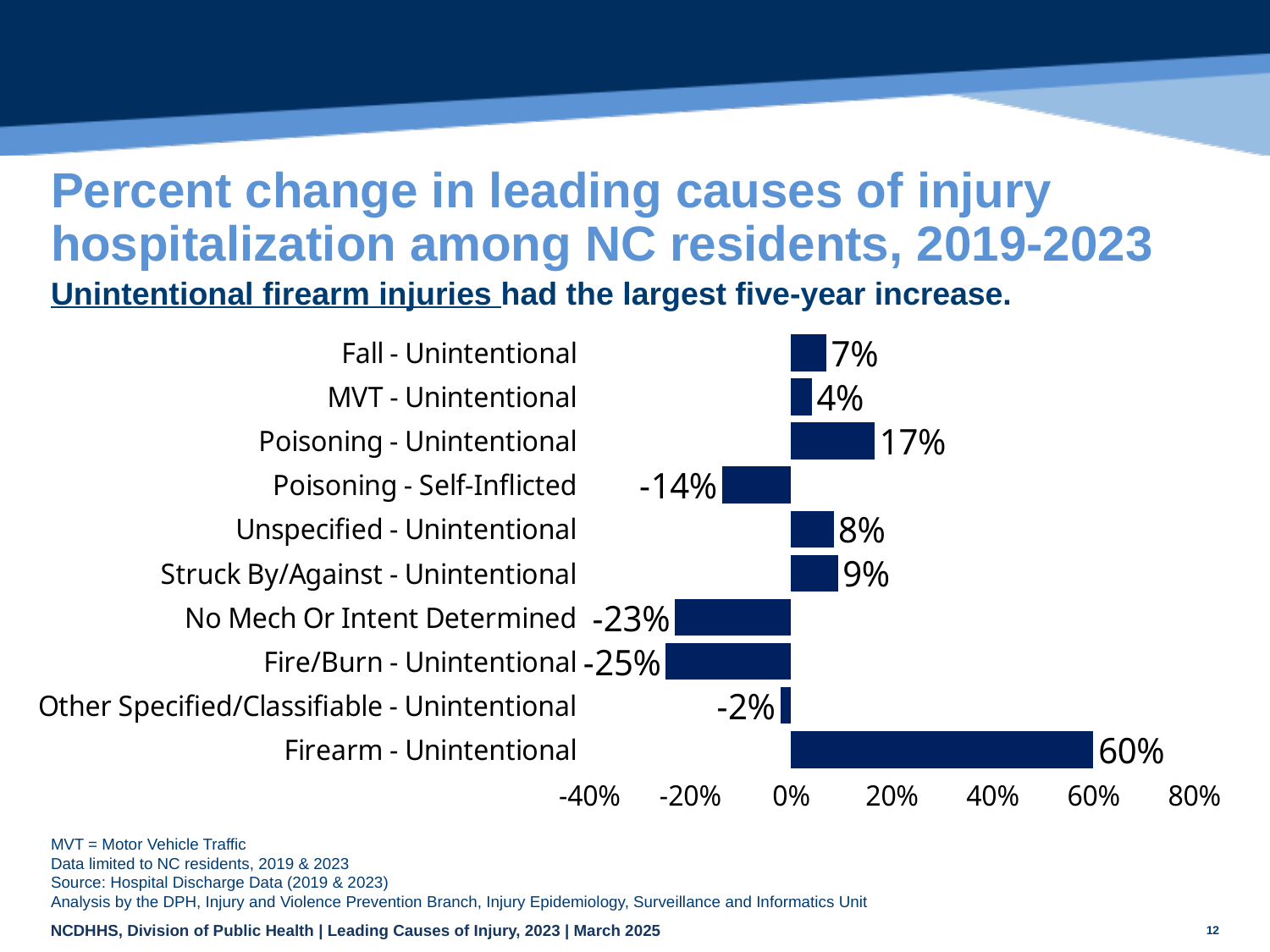
How many categories are shown in the chart? 10 Which category has the lowest percent change? Fire/Burn - Unintentional Which category has the highest percent change? Firearm - Unintentional What is the percent change for Fire/Burn - Unintentional? -25% Which has a larger percent change, Struck By/Against - Unintentional or Unspecified - Unintentional? Struck By/Against - Unintentional What is the percent change for MVT - Unintentional? 4% What kind of chart is shown on the slide? Bar chart What is the percent change for Firearm - Unintentional? 60% How many categories show a negative percent change? 4 What is the difference between the percent change for Poisoning - Unintentional and Fall - Unintentional? 10 percentage points What is the percent change for Poisoning - Self-Inflicted? -14% Is the value for Firearm - Unintentional greater or less than 40%? greater